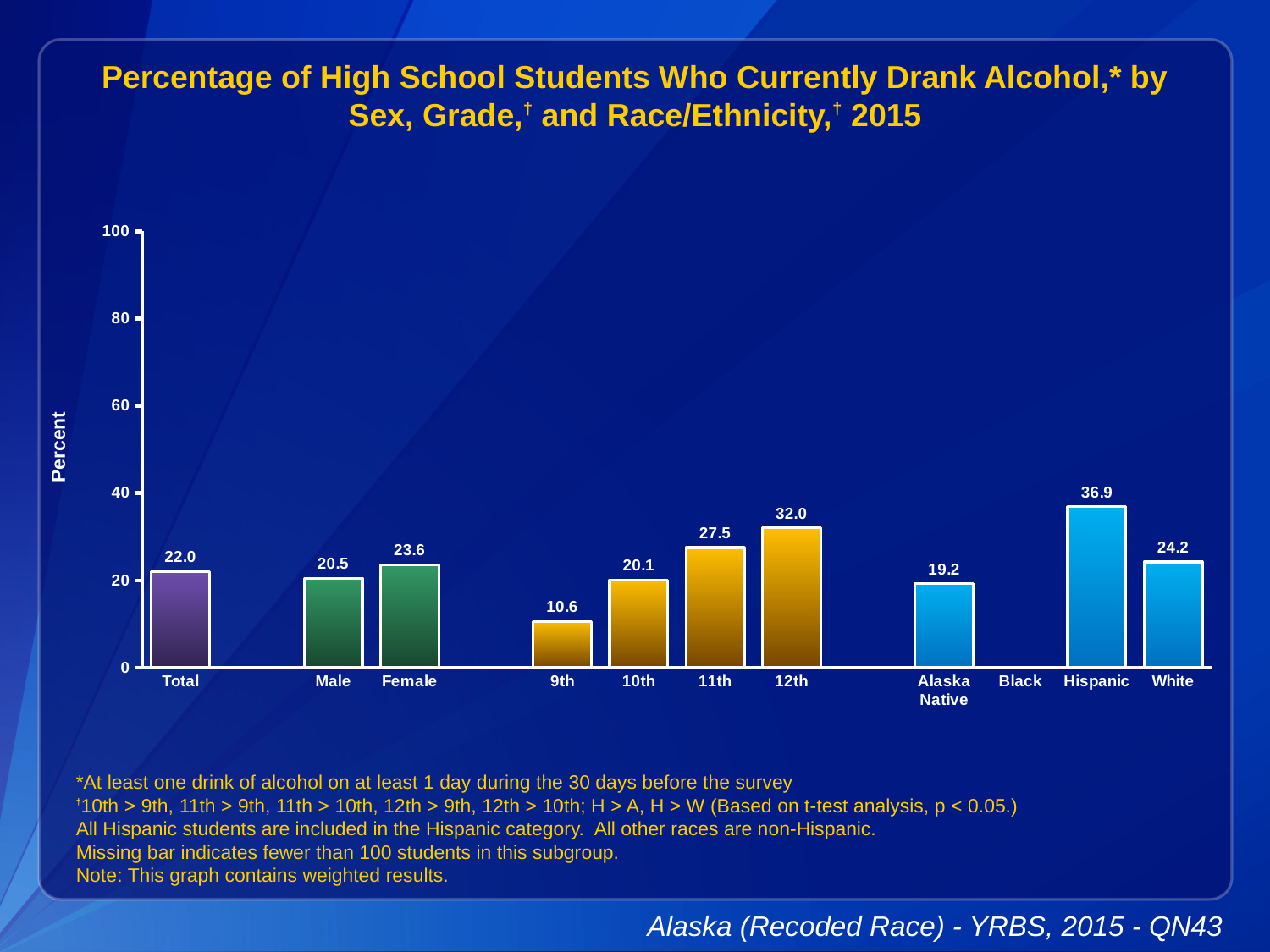
Do the values rise or fall from 9th grade to 12th grade? rise Which category has the highest value? Hispanic Is the value for Alaska Native greater or less than 20? less Which category has no bar shown? Black What kind of chart is shown on the slide? bar chart Which is larger, the value for Male or the value for Female? Female What is the value for Hispanic? 36.9 What is the value for Total? 22.0 What is the difference between the values for 12th and 9th grade? 21.4 What is the value for Female? 23.6 What is the value for 9th grade? 10.6 Which category has the lowest value? 9th